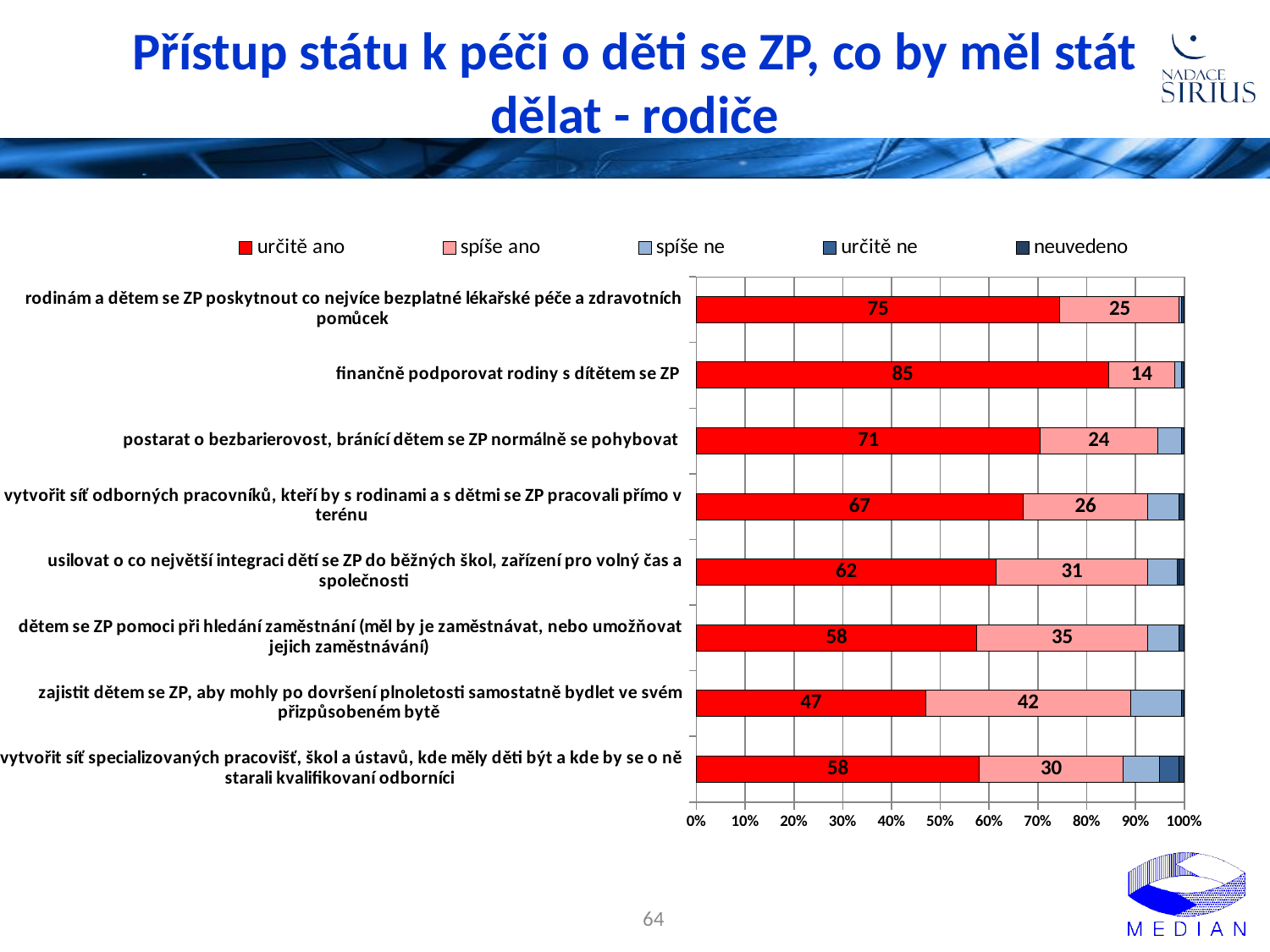
Which series is shown in red in the legend? určitě ano Which category has the highest 'určitě ano' value? finančně podporovat rodiny s dítětem se ZP Which category has the lowest 'určitě ano' value? zajistit dětem se ZP, aby mohly po dovršení plnoletosti samostatně bydlet ve svém přizpůsobeném bytě What kind of chart is shown on the slide? stacked bar chart What is the 'spíše ano' value for 'vytvořit síť specializovaných pracovišť, škol a ústavů, kde měly děti být a kde by se o ně starali kvalifikovaní odborníci'? 30 What is the 'spíše ano' value for 'zajistit dětem se ZP, aby mohly po dovršení plnoletosti samostatně bydlet ve svém přizpůsobeném bytě'? 42 What is the 'určitě ano' value for 'usilovat o co největší integraci dětí se ZP do běžných škol, zařízení pro volný čas a společnosti'? 62 How many categories are shown in the chart? 8 Which has a larger 'spíše ano' value: 'dětem se ZP pomoci při hledání zaměstnání' or 'postarat o bezbarierovost, bránící dětem se ZP normálně se pohybovat'? dětem se ZP pomoci při hledání zaměstnání How many series does the legend list? 5 What is the 'určitě ano' value for 'finančně podporovat rodiny s dítětem se ZP'? 85 What is the difference between the 'určitě ano' values for 'finančně podporovat rodiny s dítětem se ZP' and 'rodinám a dětem se ZP poskytnout co nejvíce bezplatné lékařské péče a zdravotních pomůcek'? 10